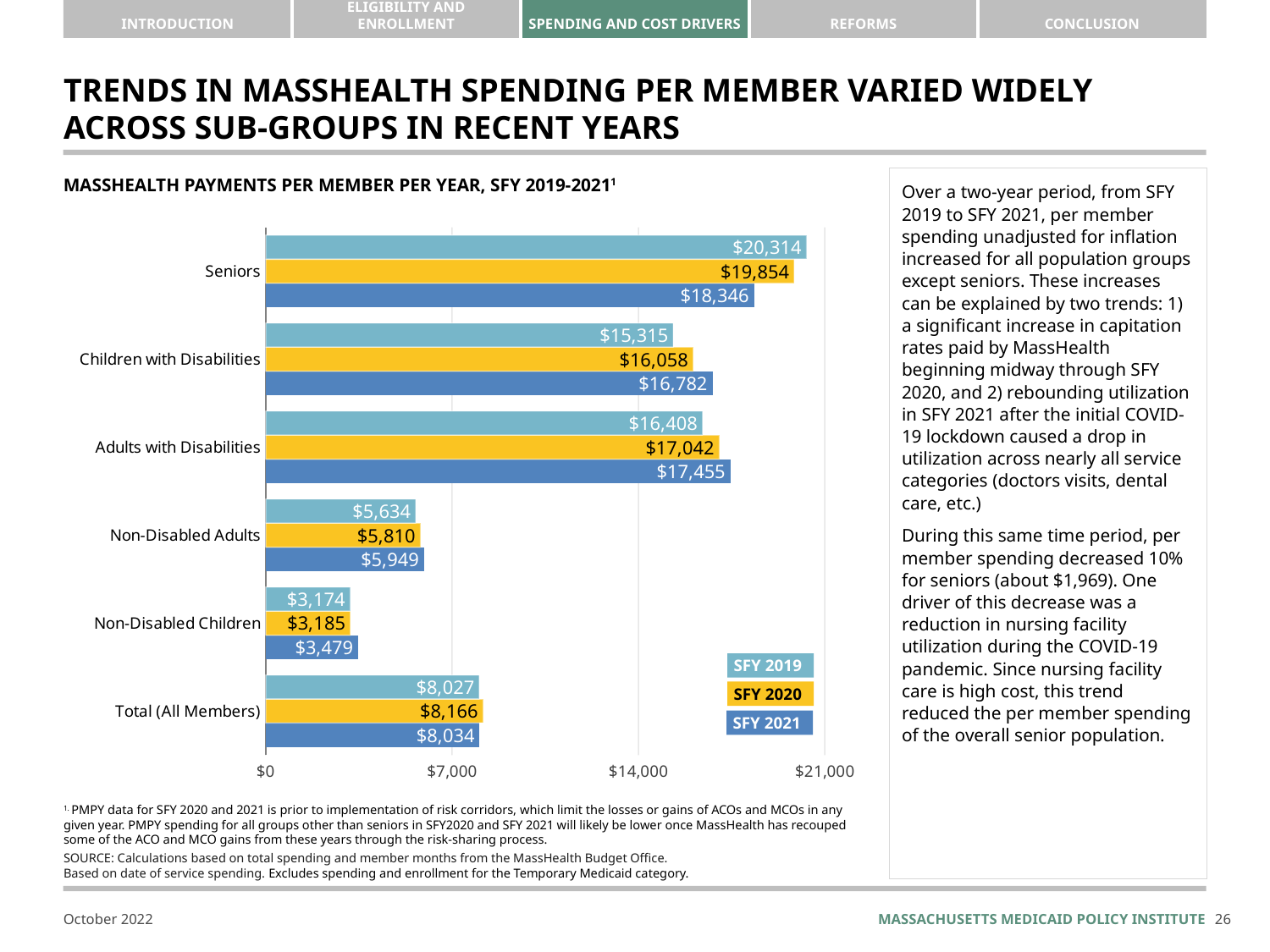
What type of chart is used to show MassHealth payments per member per year? Bar chart Which sub-group had the highest payment per member per year in SFY 2021? Seniors How many fiscal years (series) does the chart legend list? 3 By how much did the Seniors payment per member per year decrease from SFY 2019 to SFY 2021? $1,968 What was the MassHealth payment per member per year for Seniors in SFY 2019? $20,314 Did the payment per member per year for Seniors rise or fall from SFY 2019 to SFY 2021? Fall What was the payment per member per year for Non-Disabled Children in SFY 2021? $3,479 In SFY 2021, which was larger: the payment per member for Adults with Disabilities or for Children with Disabilities? Adults with Disabilities Is the SFY 2019 value for Non-Disabled Adults greater or less than $7,000? less Which sub-group had the lowest payment per member per year in SFY 2020? Non-Disabled Children How many sub-group categories are shown on the chart? 6 What is the difference between the Total (All Members) values for SFY 2020 and SFY 2019? $139